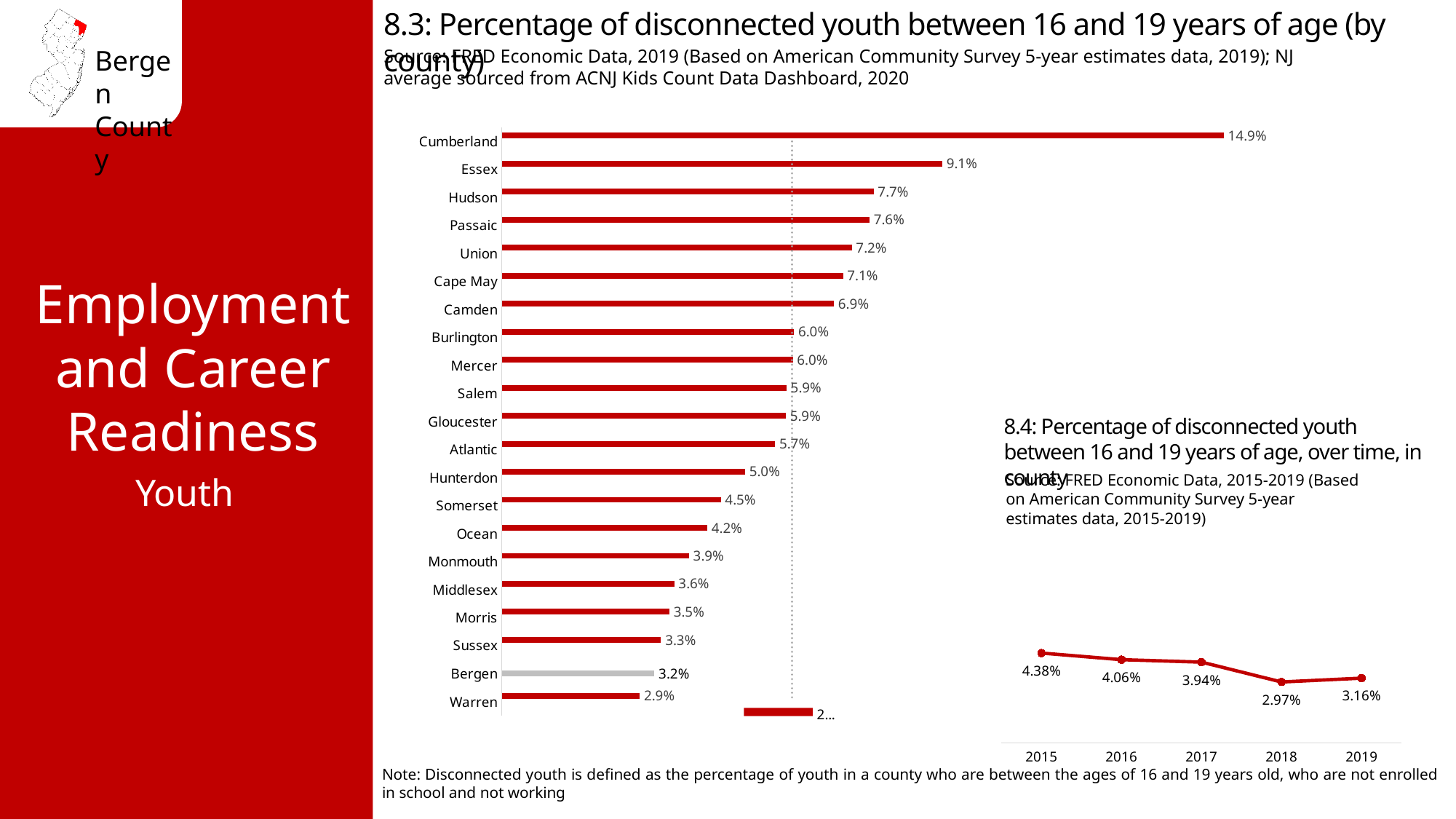
In chart 8.3 (by county), which county has the highest percentage of disconnected youth? Cumberland In chart 8.3 (by county), which has a higher value, Hudson or Passaic? Hudson In chart 8.4 (over time), how many years are plotted? 5 In chart 8.3 (percentage of disconnected youth by county), what is the value for Bergen? 3.2% In chart 8.4 (disconnected youth over time), what is the value for 2018? 2.97% In chart 8.3 (by county), what is the value for Hunterdon? 5.0% In chart 8.3 (by county), how many counties are shown? 21 In chart 8.4 (over time), which year has the highest value? 2015 In chart 8.3 (by county), what is the difference between the values for Cumberland and Essex? 5.8% In chart 8.4 (over time), what is the difference between the 2015 and 2019 values? 1.22% In chart 8.3 (by county), which county has the lowest percentage of disconnected youth? Warren What kind of chart is chart 8.3 (percentage of disconnected youth by county)? Bar chart